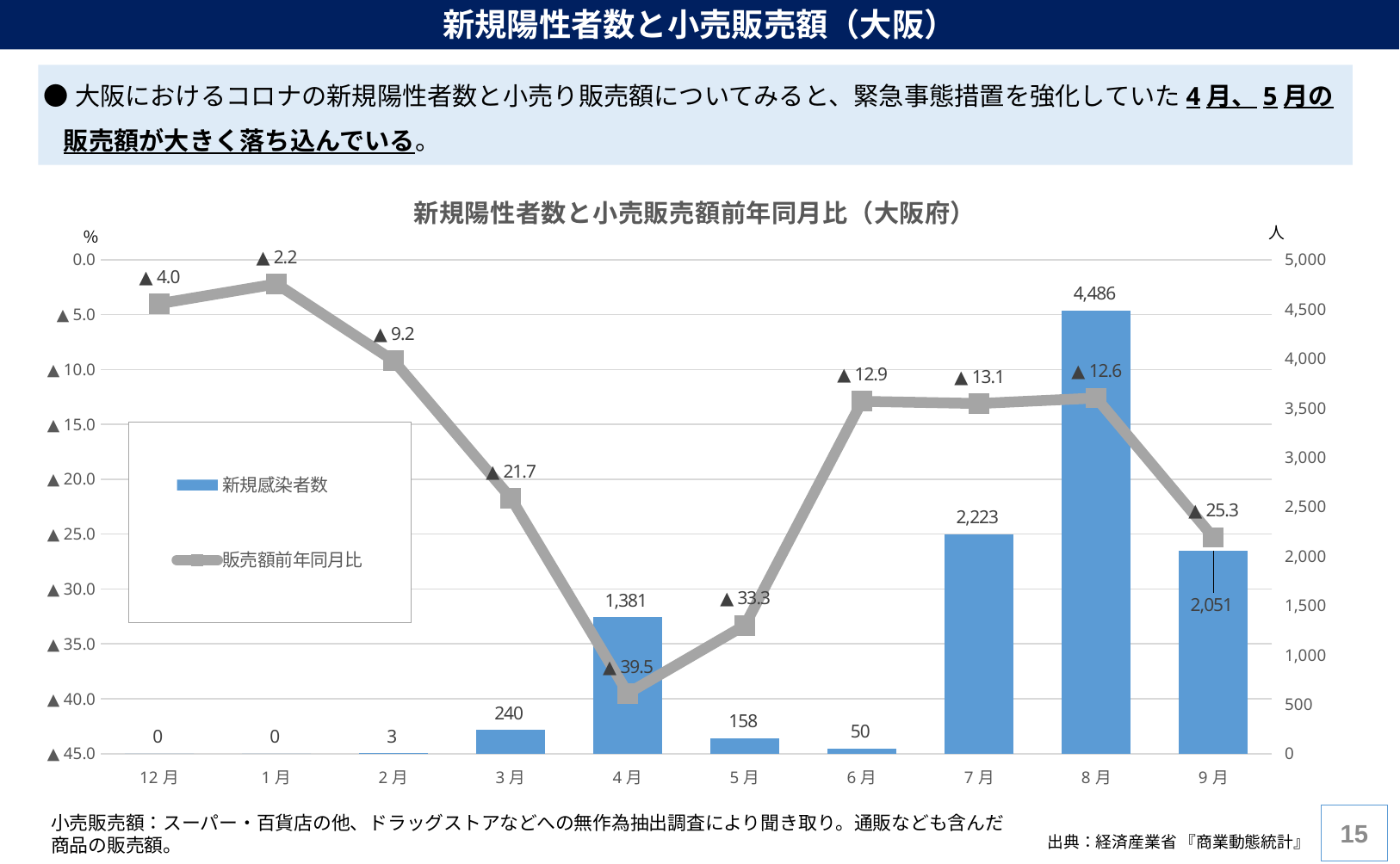
このグラフのタイトルは何ですか？ 新規陽性者数と小売販売額前年同月比（大阪府） 新規感染者数はどの種類のグラフで表されていますか？ 棒グラフ 3月と5月では、どちらの新規感染者数が多いですか？ 3月 新規感染者数が最も多い月はどれですか？ 8月 横軸には何か月分のデータがありますか？ 10 8月と9月の新規感染者数の差はいくつですか？ 2,435 8月の新規感染者数はいくつですか？ 4,486 4月の販売額前年同月比の値はいくつですか？ ▲39.5 7月の新規感染者数はいくつですか？ 2,223 凡例にはいくつの系列が示されていますか？ 2 販売額前年同月比が最も低い月はどれですか？ 4月 販売額前年同月比は1月から4月にかけて上昇していますか、下降していますか？ 下降